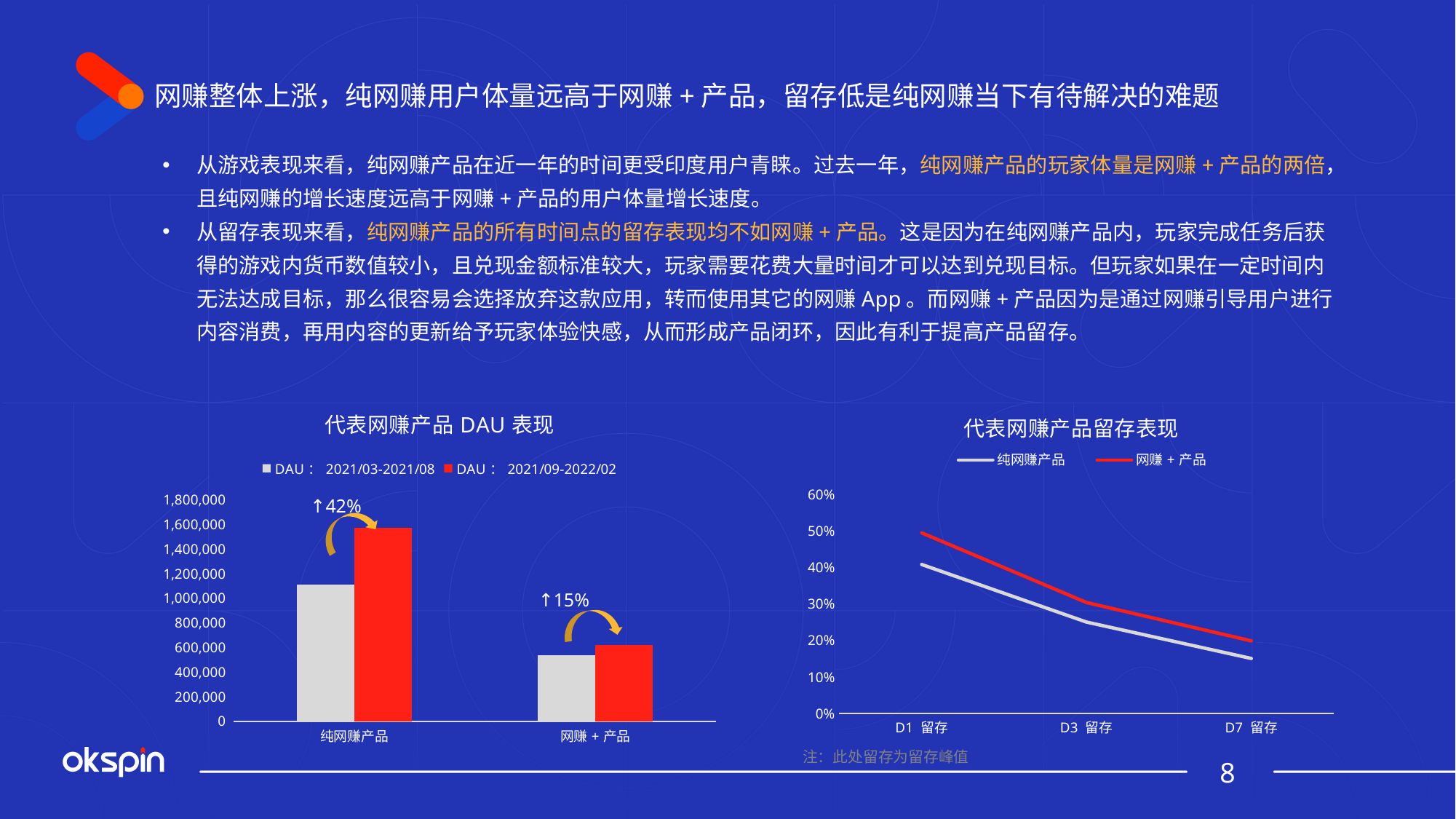
In the chart titled 代表网赚产品 DAU 表现, what growth percentage is labelled above the bars for 网赚 + 产品? ↑15% In the chart titled 代表网赚产品 DAU 表现, how many series does the legend list? 2 In the chart titled 代表网赚产品 DAU 表现, is the DAU: 2021/09-2022/02 value for 纯网赚产品 greater or less than 1,400,000? greater In the chart titled 代表网赚产品留存表现, how many points are shown on the x axis? 3 In the chart titled 代表网赚产品 DAU 表现, how many categories are shown on the x axis? 2 In the chart titled 代表网赚产品 DAU 表现, which category has the higher DAU: 2021/09-2022/02 value, 纯网赚产品 or 网赚 + 产品? 纯网赚产品 In the chart titled 代表网赚产品留存表现, is the D1 留存 value for 网赚 + 产品 greater or less than 40%? greater In the chart titled 代表网赚产品留存表现, what kind of chart is it? line chart In the chart titled 代表网赚产品 DAU 表现, what kind of chart is it? bar chart In the chart titled 代表网赚产品留存表现, do the values for 纯网赚产品 rise or fall from D1 留存 to D7 留存? fall In the chart titled 代表网赚产品留存表现, how many series does the legend list? 2 In the chart titled 代表网赚产品 DAU 表现, what growth percentage is labelled above the bars for 纯网赚产品? ↑42%